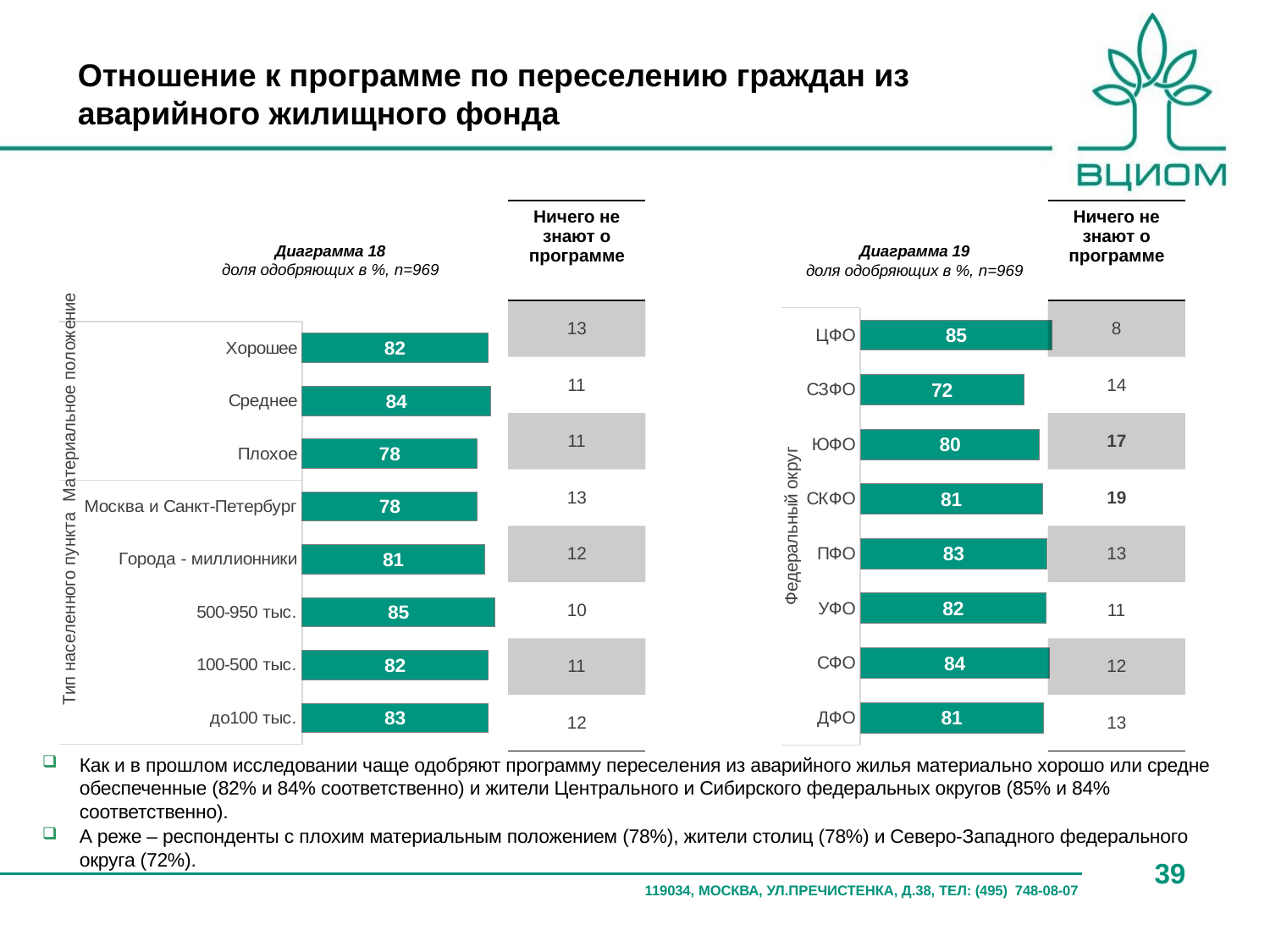
In Диаграмма 19, which federal district has the lowest value? СЗФО In Диаграмма 19, which federal district has the highest value? ЦФО In Диаграмма 18, which is larger: the value for Хорошее or the value for до100 тыс.? до100 тыс. In Диаграмма 18, what is the value for Города - миллионники? 81 In Диаграмма 19, what is the difference between the values for ЦФО and СЗФО? 13 In Диаграмма 18, how many categories are plotted? 8 In Диаграмма 19, what is the value for СЗФО? 72 In Диаграмма 19, what is the value for ПФО? 83 In Диаграмма 18, what is the difference between the values for Среднее and Плохое? 6 What kind of chart is Диаграмма 19? Bar chart In Диаграмма 18, what is the value for Среднее? 84 In Диаграмма 18, which category has the highest value? 500-950 тыс.